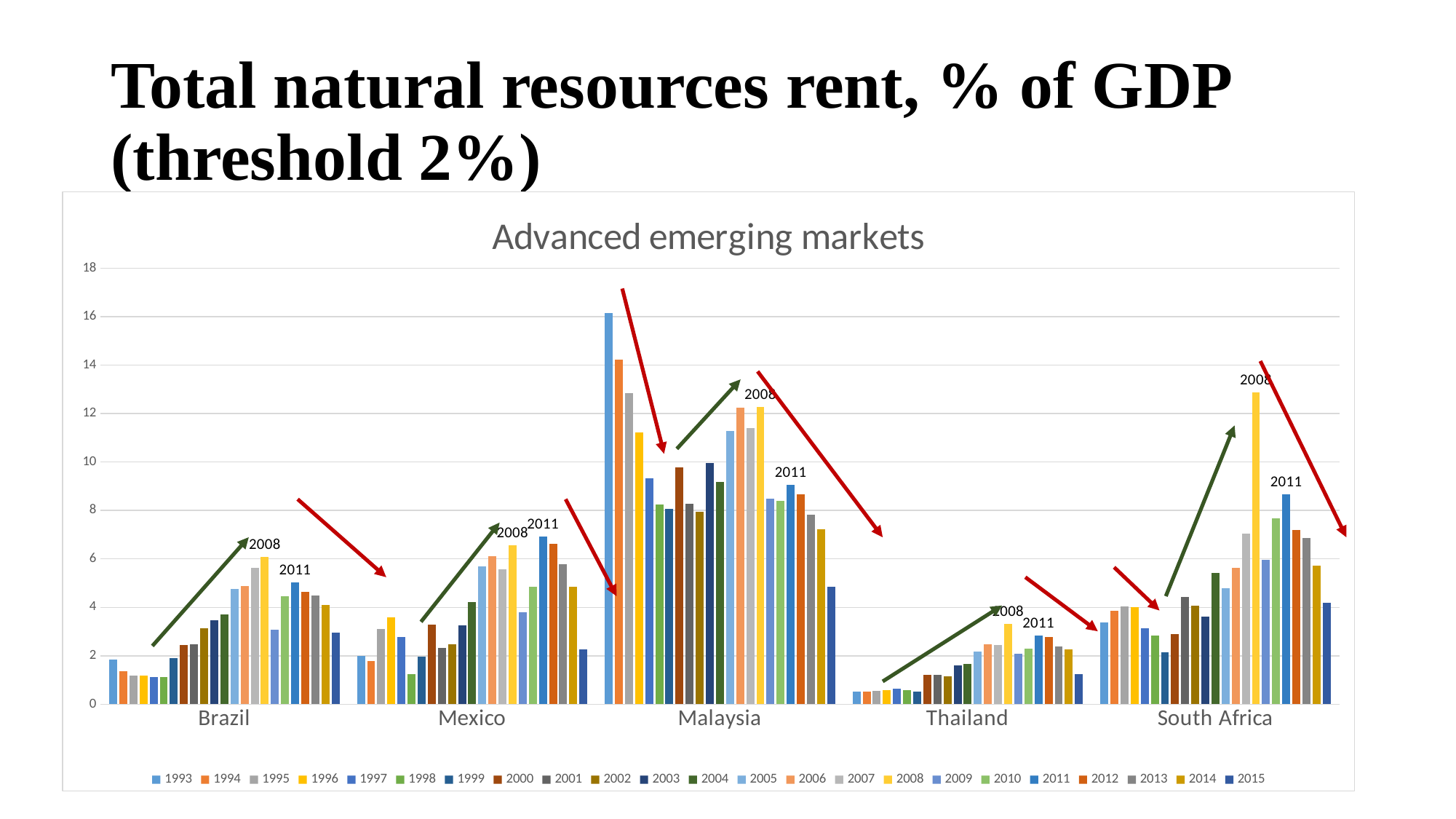
Which country has the lowest bars overall in the chart? Thailand What is the title of the chart? Advanced emerging markets Which is larger: the 2008 value for Thailand or the 2008 value for South Africa? South Africa Is the value for Mexico in 2011 greater or less than 8? less Is the value for South Africa in 2008 greater or less than 12? greater How many years (series) does the legend list? 23 What type of chart is shown on the slide? Bar chart Which is larger: the 1993 value for Malaysia or the 2008 value for South Africa? Malaysia Is the value for Malaysia in 1993 greater or less than 14? greater How many countries are shown on the x axis of the chart? 5 Which country has the tallest bar in the chart? Malaysia